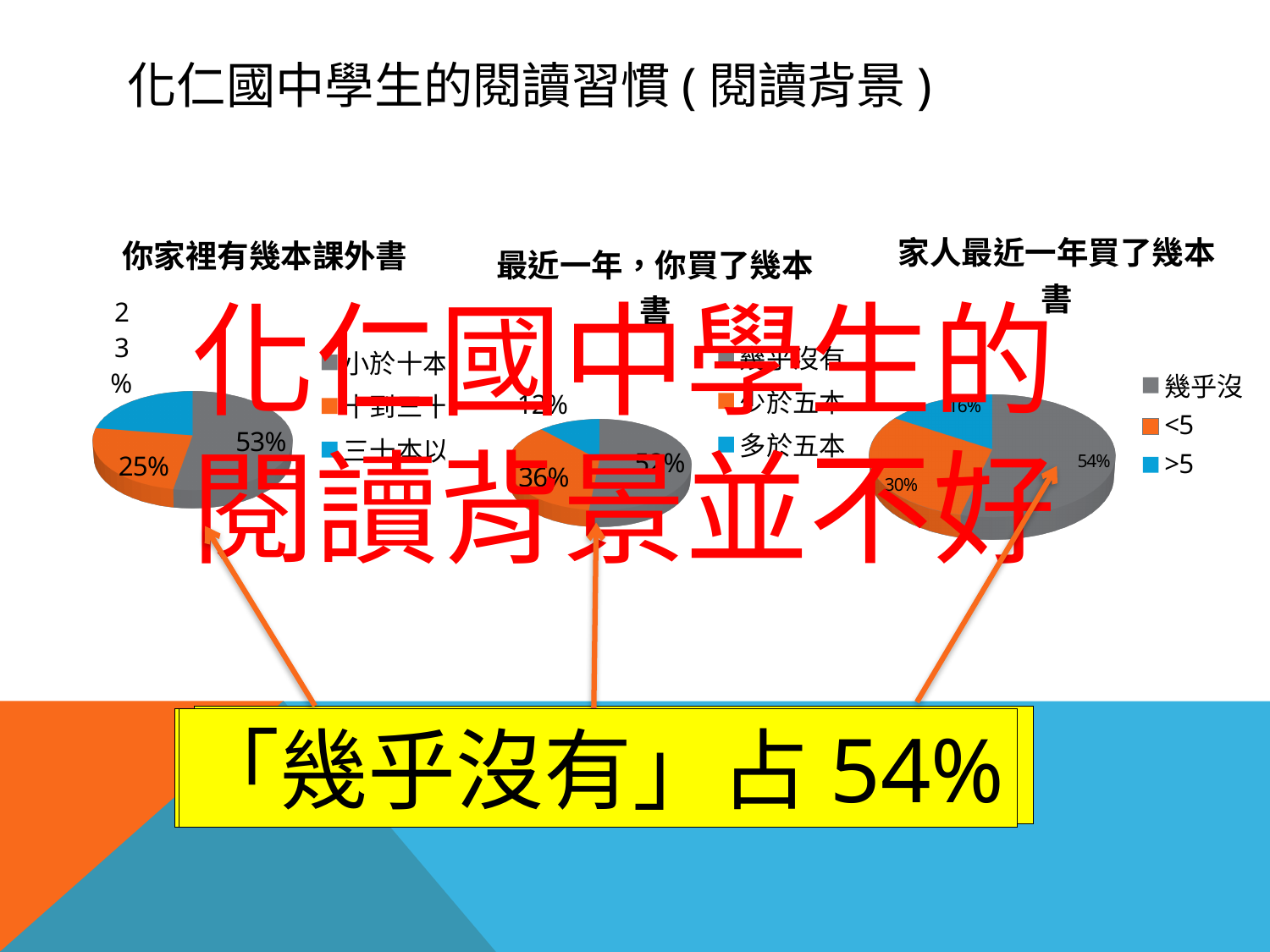
In the chart titled 家人最近一年買了幾本書, what is the difference between the 幾乎沒 share and the <5 share? 24% In the chart titled 家人最近一年買了幾本書, what share is labelled for the <5 slice? 30% In the chart titled 家人最近一年買了幾本書, which category has the smallest slice? >5 In the chart titled 你家裡有幾本課外書, what share is labelled for the 小於十本 slice? 53% In the chart titled 家人最近一年買了幾本書, what share is labelled for the >5 slice? 16% In the chart titled 你家裡有幾本課外書, is the 53% slice or the 25% slice larger? 53% In the chart titled 家人最近一年買了幾本書, how many entries does the legend list? 3 In the chart titled 家人最近一年買了幾本書, which category has the largest slice? 幾乎沒 In the chart titled 家人最近一年買了幾本書, what share is labelled for the 幾乎沒 slice? 54% How many pie charts are shown on the slide? 3 In the chart titled 你家裡有幾本課外書, what share is labelled for the orange slice? 25% What kind of chart is the chart titled 家人最近一年買了幾本書? pie chart